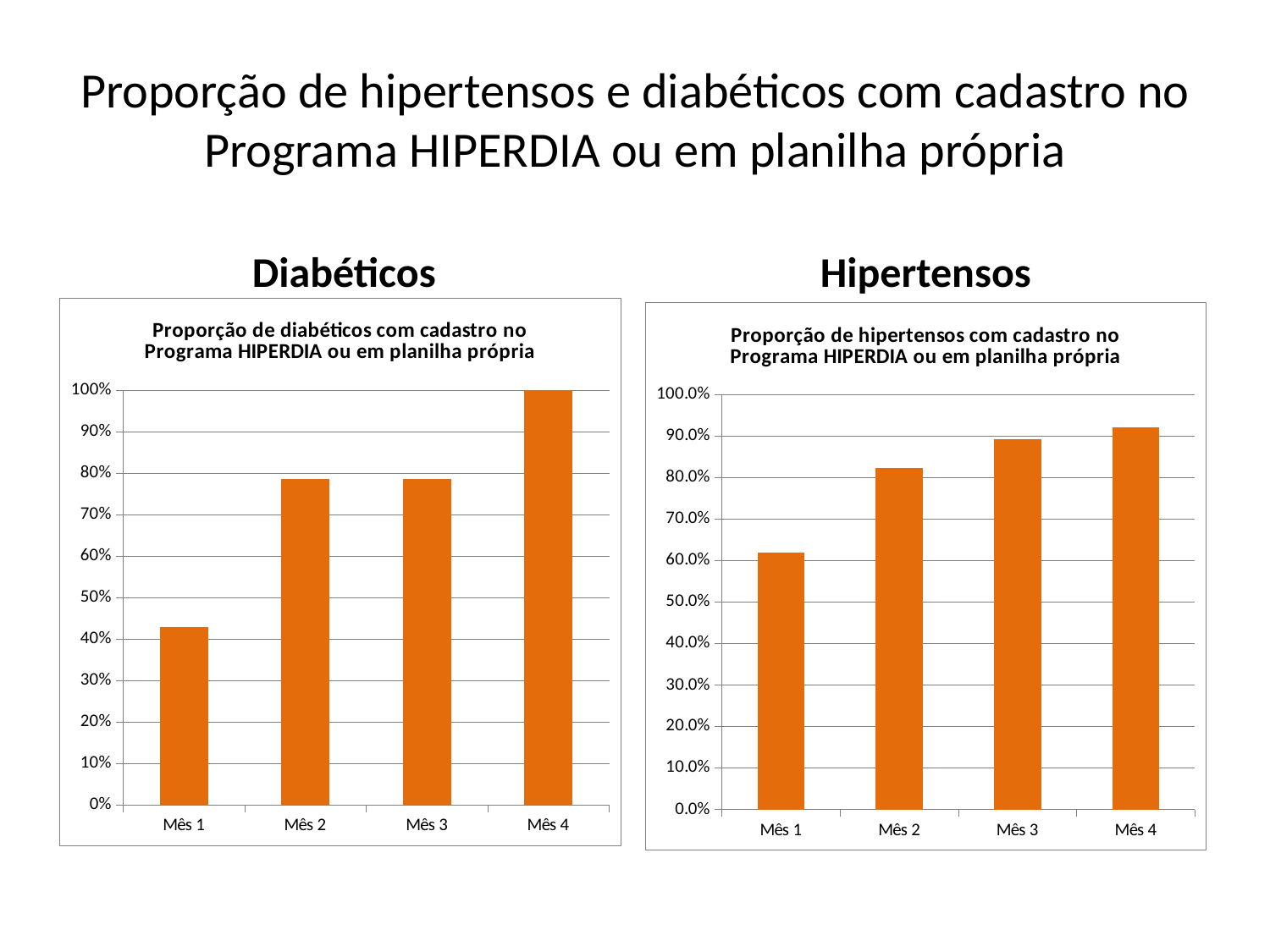
In the Diabéticos chart, is the value for Mês 1 greater or less than 50%? less In the Hipertensos chart, which is larger, the value for Mês 1 or the value for Mês 2? Mês 2 In the Diabéticos chart, which month has the highest value? Mês 4 In the Hipertensos chart, which month has the lowest value? Mês 1 In the Hipertensos chart, do the values rise or fall from Mês 1 to Mês 4? rise How many months are shown on the x axis of the Hipertensos chart? 4 In the Hipertensos chart, is the value for Mês 3 greater or less than 80.0%? greater What kind of chart is the Diabéticos chart? bar chart In the Diabéticos chart, which month has the lowest value? Mês 1 In the Hipertensos chart, is the value for Mês 1 greater or less than 70.0%? less In the Diabéticos chart, what is the value for Mês 4? 100%